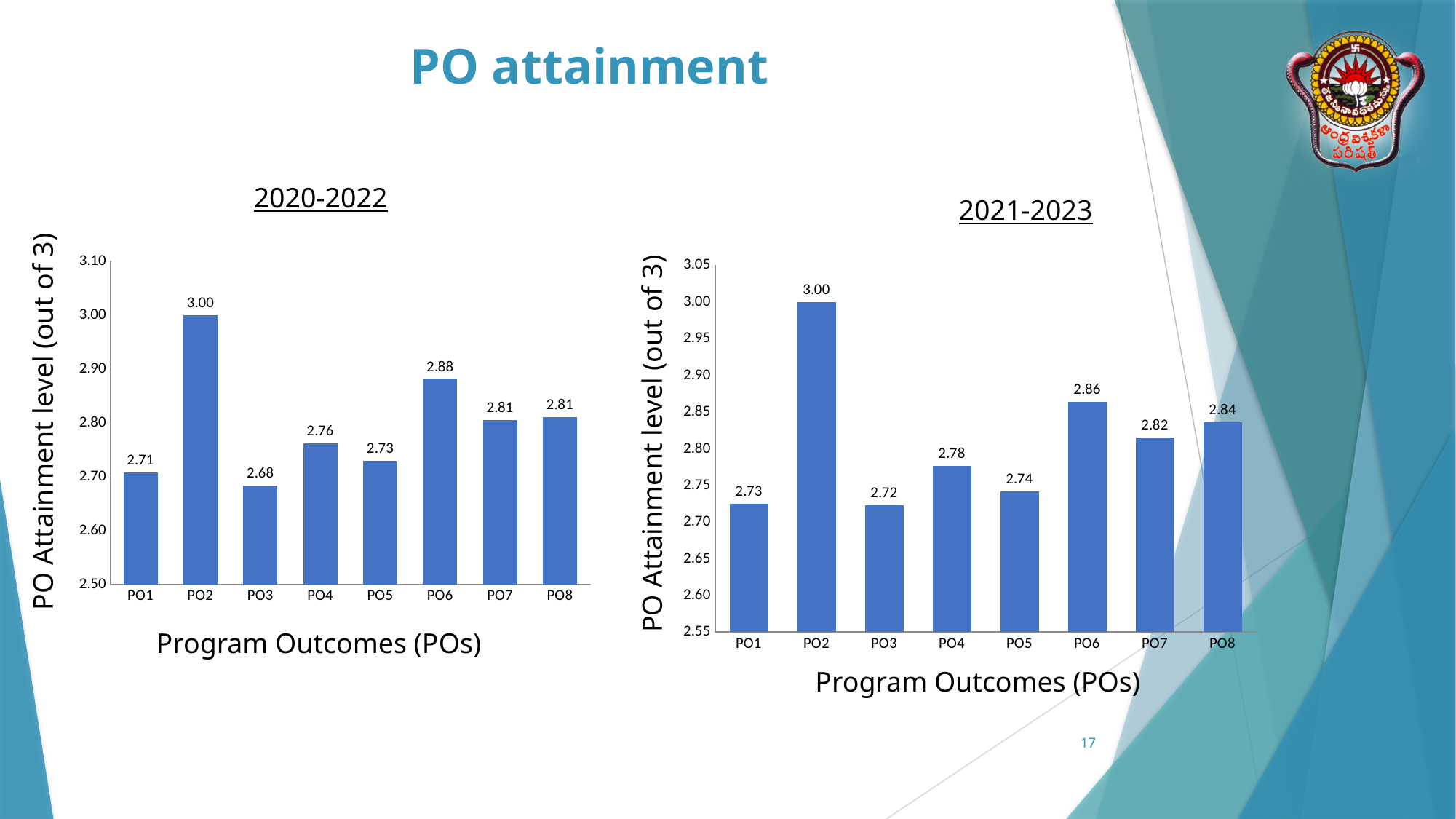
In the 2021-2023 chart, which program outcome has the lowest attainment level? PO3 How many program outcomes are shown in the 2020-2022 chart? 8 In the 2020-2022 chart, which program outcome has the lowest attainment level? PO3 In the 2021-2023 chart, is the value for PO7 greater or less than 2.80? greater In the 2020-2022 chart, which is larger, the attainment level for PO4 or for PO5? PO4 In the 2020-2022 chart, what is the PO attainment level for PO6? 2.88 In the 2021-2023 chart, which program outcome has the highest attainment level? PO2 In the 2021-2023 chart, what is the PO attainment level for PO4? 2.78 What type of chart is used for the 2021-2023 data? Bar chart In the 2021-2023 chart, what is the difference between the attainment levels of PO6 and PO5? 0.12 What is the y-axis label of the 2020-2022 chart? PO Attainment level (out of 3) In the 2020-2022 chart, what is the difference between the attainment levels of PO2 and PO3? 0.32